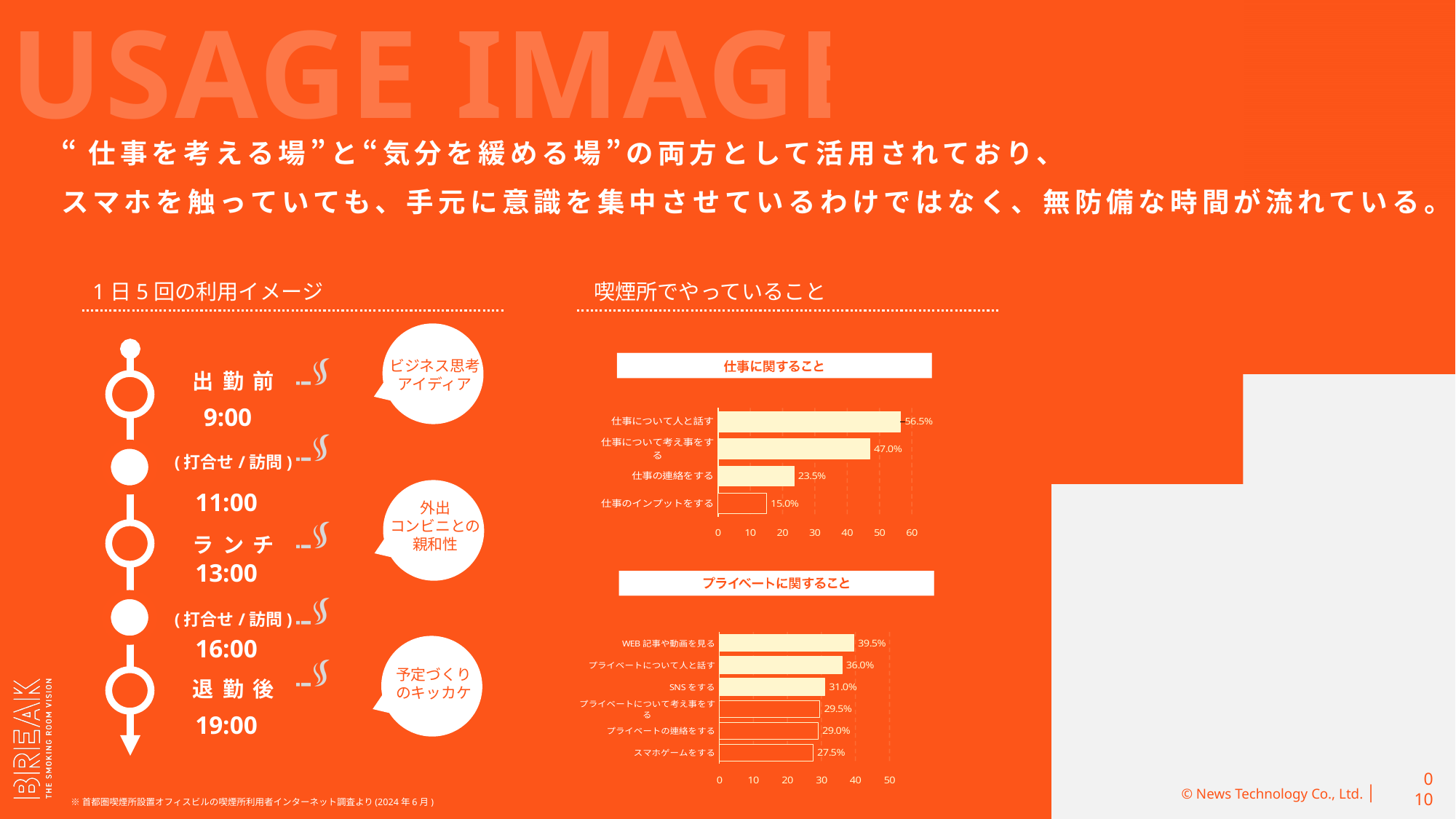
In the プライベートに関すること chart, what is the value for スマホゲームをする? 27.5% In the 仕事に関すること chart, what is the value for 仕事のインプットをする? 15.0% In the プライベートに関すること chart, which category has the lowest value? スマホゲームをする In the プライベートに関すること chart, what is the value for SNSをする? 31.0% What type of chart is the 仕事に関すること chart? Bar chart In the 仕事に関すること chart, what is the value for 仕事について人と話す? 56.5% In the プライベートに関すること chart, how many categories are shown? 6 In the 仕事に関すること chart, which category has the highest value? 仕事について人と話す In the 仕事に関すること chart, how many categories are shown? 4 In the 仕事に関すること chart, what is the difference between 仕事について考え事をする and 仕事の連絡をする? 23.5% In the プライベートに関すること chart, what is the difference between WEB記事や動画を見る and SNSをする? 8.5% In the プライベートに関すること chart, which is larger: WEB記事や動画を見る or プライベートについて人と話す? WEB記事や動画を見る